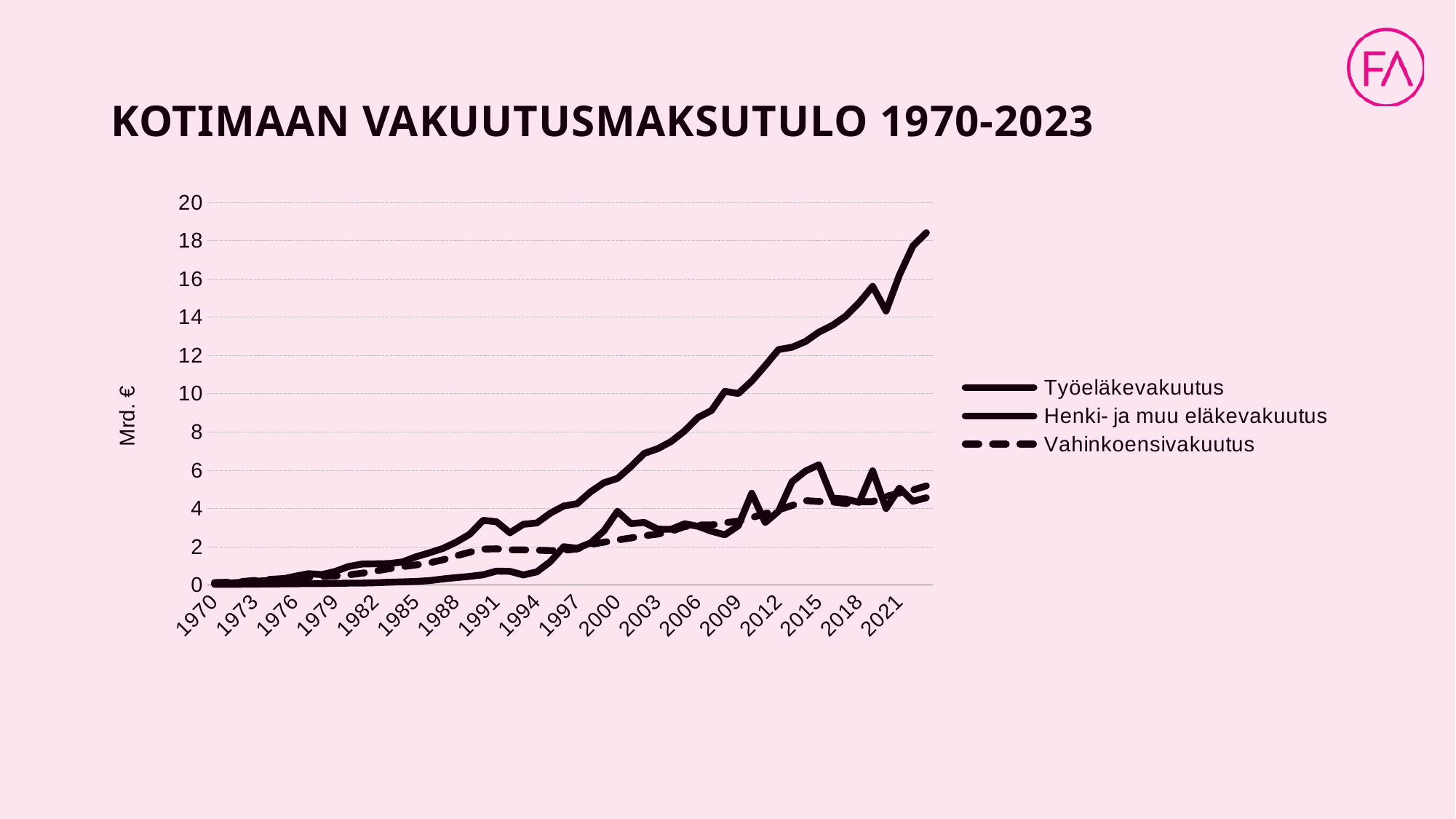
Is the value for Vahinkoensivakuutus in 1985 greater or less than 2? less Which series reaches the highest value on the chart? Työeläkevakuutus What unit is shown on the vertical axis label? Mrd. € What is the title of the chart? KOTIMAAN VAKUUTUSMAKSUTULO 1970-2023 Is the value for Työeläkevakuutus in 2015 greater or less than 12? greater Does the Työeläkevakuutus series generally rise or fall from 1970 to 2023? rise Which series has the lowest value in 1994? Henki- ja muu eläkevakuutus Is the value for Henki- ja muu eläkevakuutus in 2015 greater or less than 8? less How many series does the legend list? 3 What kind of chart is shown on the slide? line chart